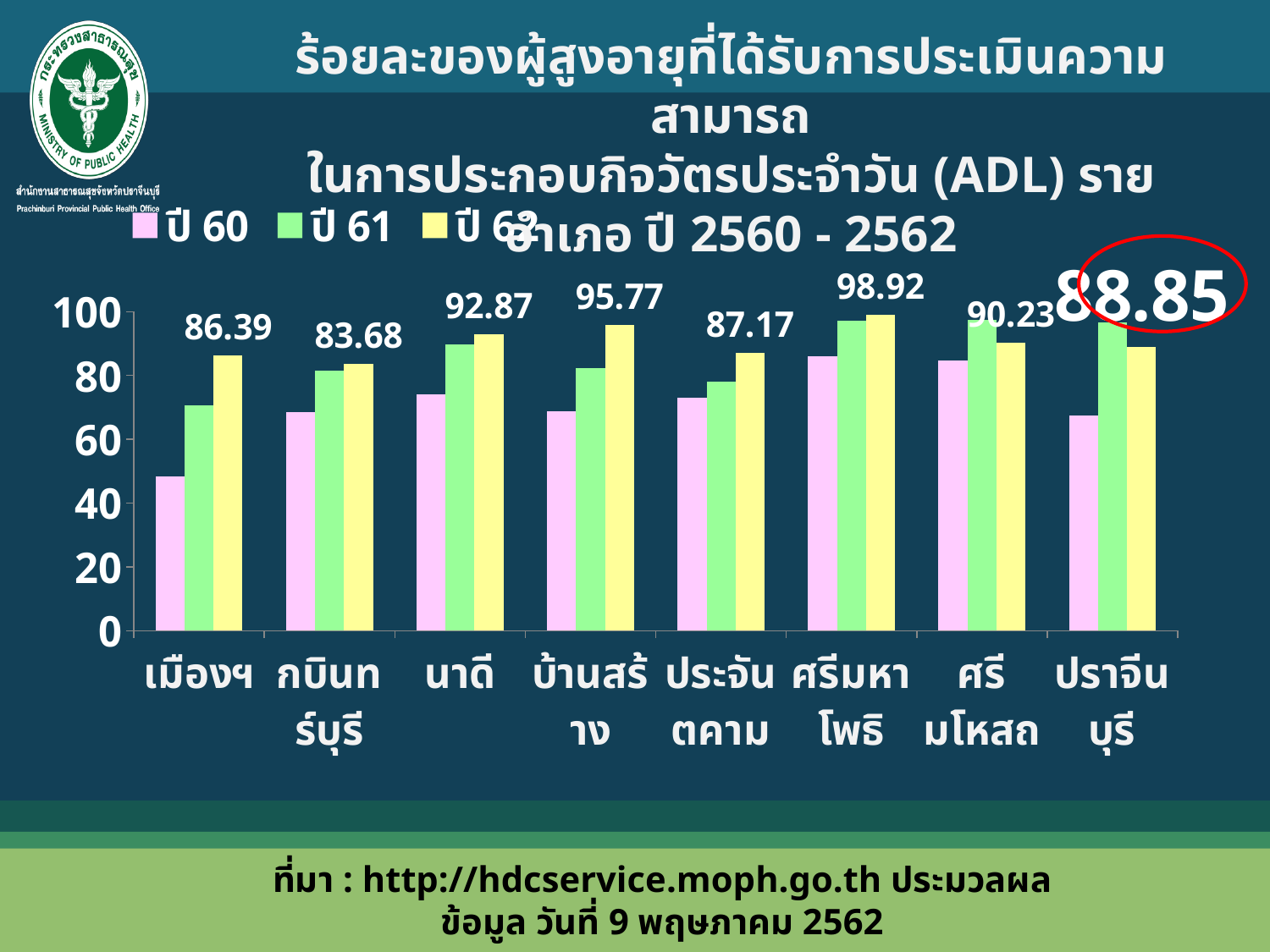
How many series does the legend list? 3 Is the ปี 61 value for ศรีมหาโพธิ greater or less than 80? greater Which has the larger ปี 62 value, บ้านสร้าง or นาดี? บ้านสร้าง What is the ปี 62 value for ปราจีนบุรี? 88.85 What is the ปี 62 value for นาดี? 92.87 Which district has the lowest ปี 62 value? กบินทร์บุรี Which district has the highest ปี 62 value? ศรีมหาโพธิ What is the difference between the ปี 62 values for ศรีมหาโพธิ and กบินทร์บุรี? 15.24 What kind of chart is shown on the slide? bar chart Is the ปี 60 value for เมืองฯ greater or less than 60? less How many districts are shown on the x axis? 8 What is the ปี 62 value for ศรีมหาโพธิ? 98.92